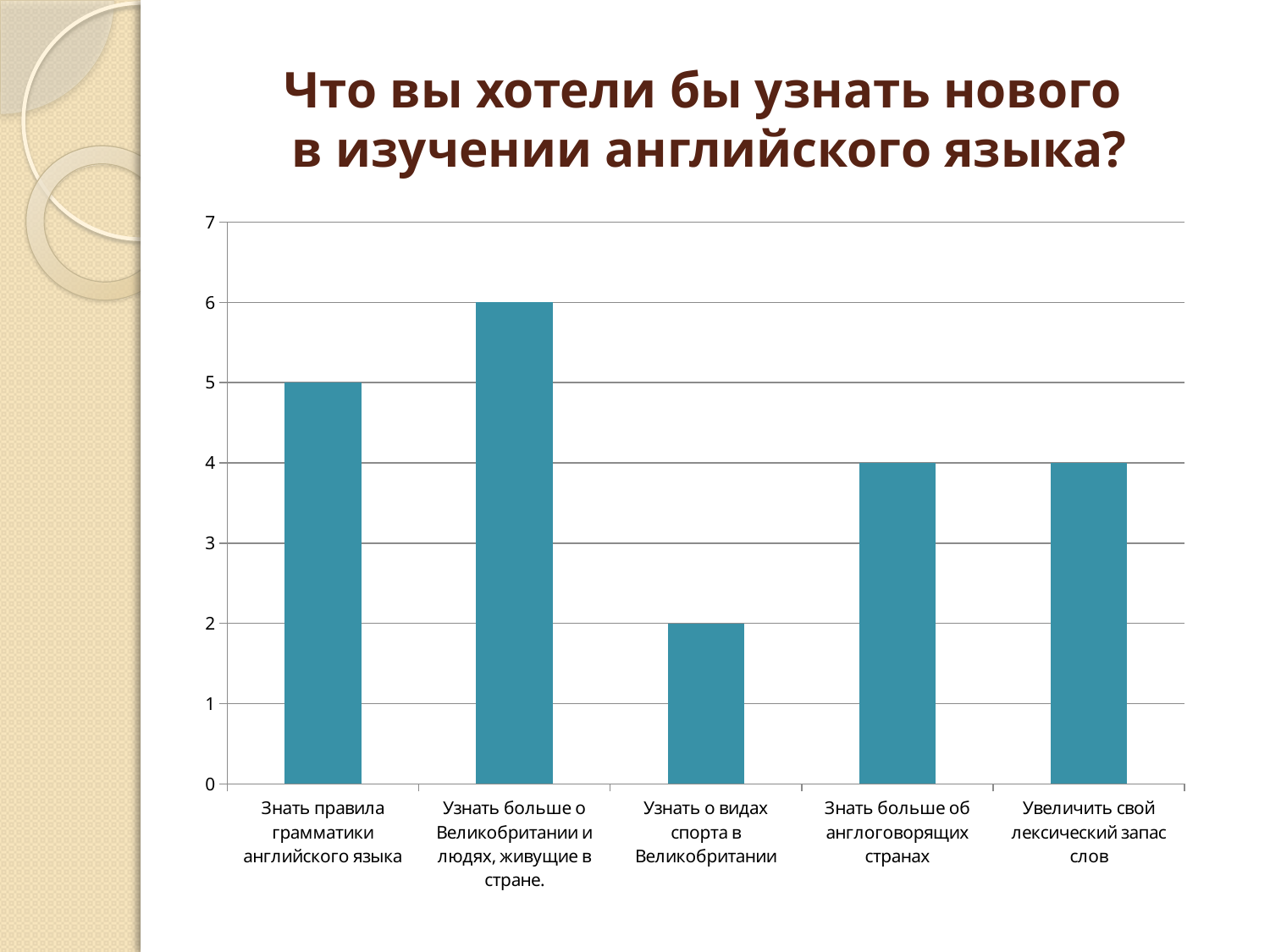
What is the difference between the values for "Узнать больше о Великобритании и людях, живущие в стране." and "Узнать о видах спорта в Великобритании"? 4 How many categories are shown on the x axis? 5 Which is larger: the value for "Знать правила грамматики английского языка" or the value for "Увеличить свой лексический запас слов"? Знать правила грамматики английского языка Is the value for "Узнать о видах спорта в Великобритании" greater or less than 3? less What is the value for "Знать больше об англоговорящих странах"? 4 Which category has the lowest value? Узнать о видах спорта в Великобритании What is the value for "Узнать больше о Великобритании и людях, живущие в стране."? 6 What is the value for "Знать правила грамматики английского языка"? 5 What is the value for "Узнать о видах спорта в Великобритании"? 2 What is the title of the slide above the chart? Что вы хотели бы узнать нового в изучении английского языка? What kind of chart is shown on the slide? bar chart Which category has the highest value? Узнать больше о Великобритании и людях, живущие в стране.